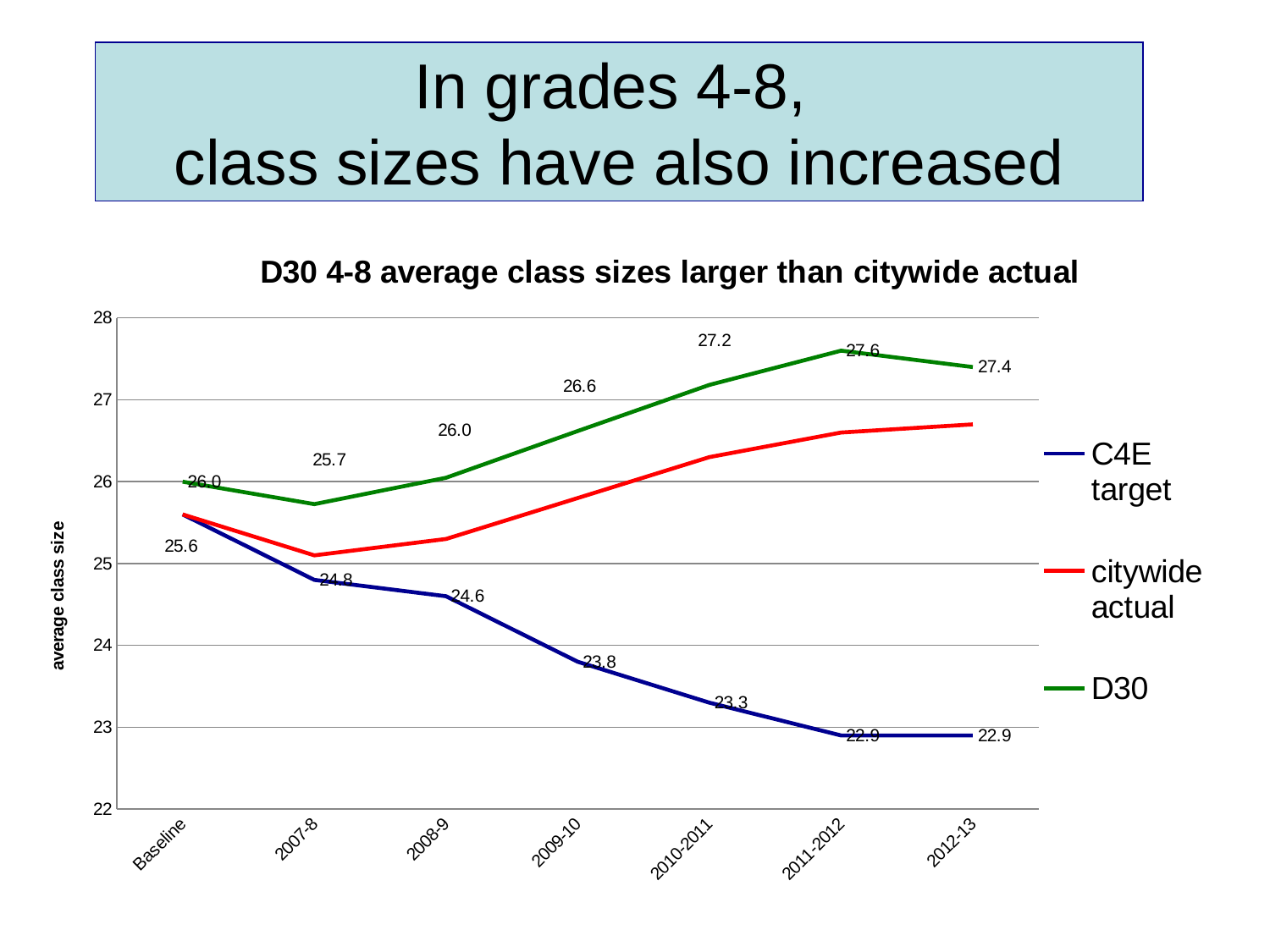
In which year is the D30 value lowest? 2007-8 How many series does the legend list? 3 Does the C4E target series rise or fall from Baseline to 2012-13? fall What is the difference between the D30 value and the C4E target value in 2012-13? 4.5 What kind of chart is shown on the slide? line chart In which year is the D30 value highest? 2011-2012 How many points are plotted along the x axis for each series? 7 What is the D30 value for 2011-2012? 27.6 Is the citywide actual value for 2012-13 greater or less than 26? greater At Baseline, which is larger: the D30 value or the C4E target value? D30 What is the C4E target value for 2009-10? 23.8 What is the label on the vertical axis? average class size